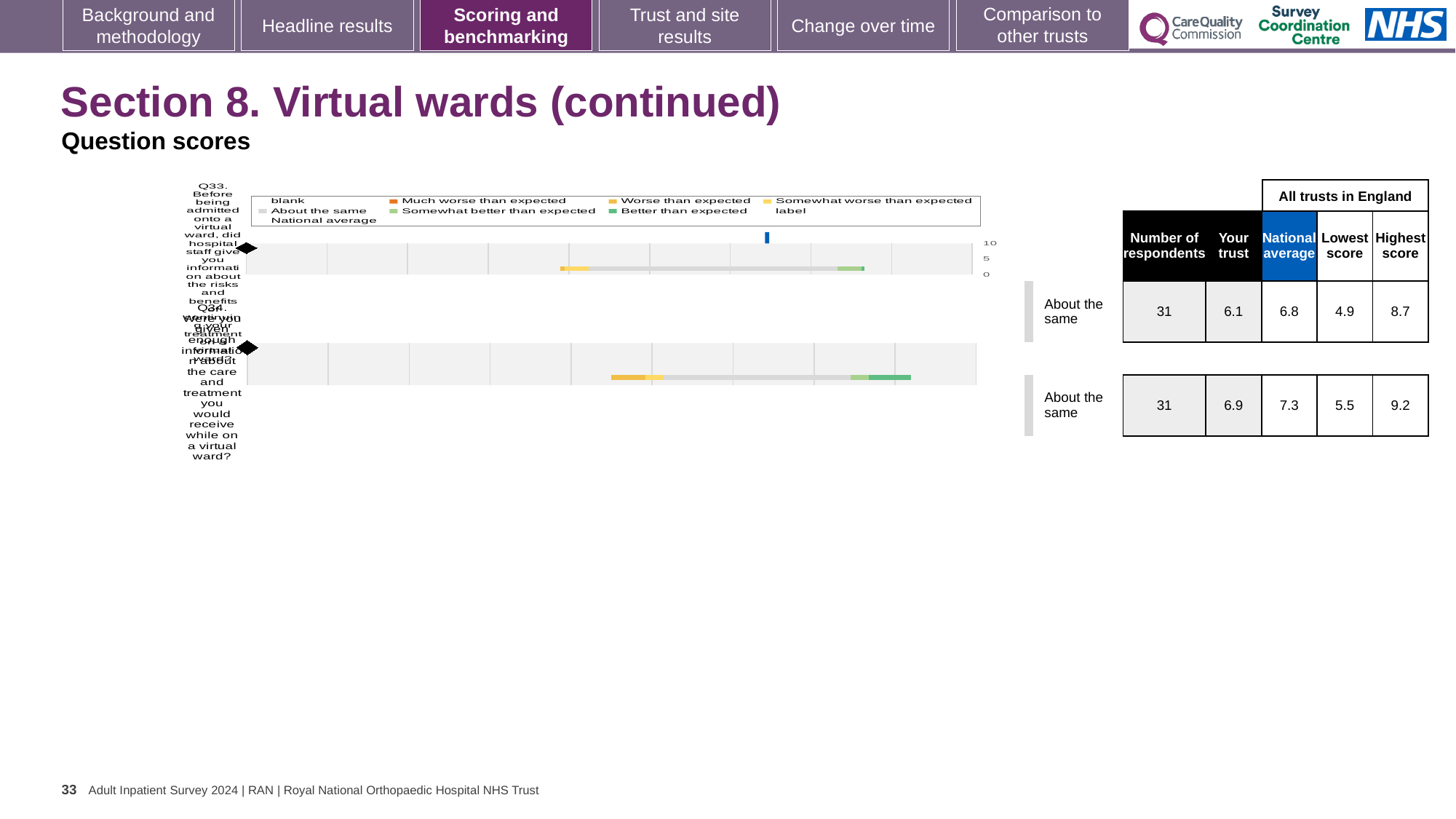
What is the lowest score across all trusts in England for Q33? 4.9 What is the 'Your trust' score for Q33 in the table next to the chart? 6.1 How many entries does the chart legend list? 9 How many respondents are listed for Q33? 31 What is the highest score across all trusts in England for Q34? 9.2 What is the national average score for Q34 in the table next to the chart? 7.3 What kind of chart is used to show the question scores on this slide? bar chart For Q33, how much higher is the national average than the 'Your trust' score? 0.7 How many questions (bars) are plotted in the chart? 2 What is the difference between the highest score and the lowest score for Q34? 3.7 For Q33, which is larger: the 'Your trust' score or the national average? National average What benchmark category is shown for Q34 next to the chart? About the same